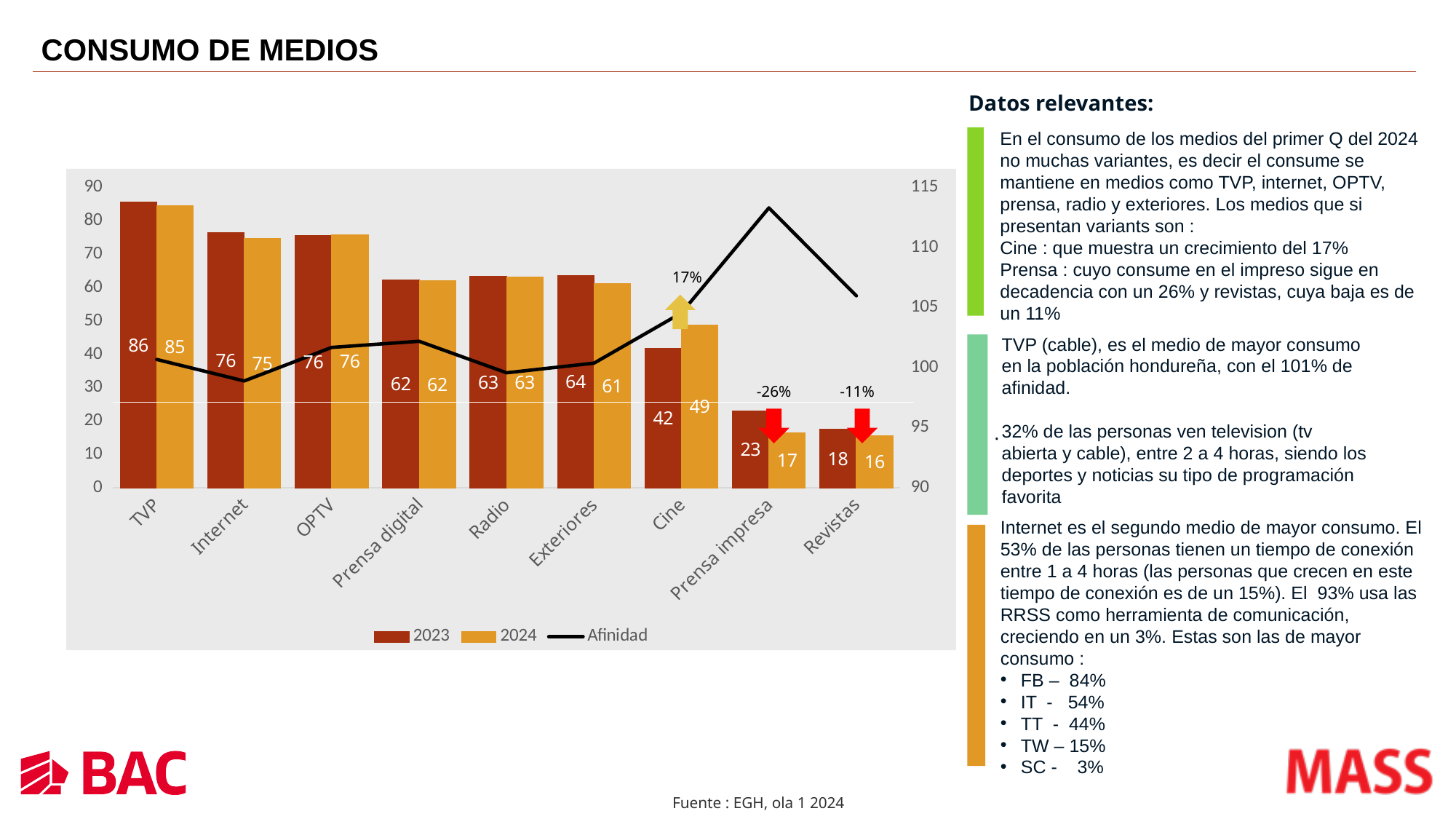
By how much did the Cine value increase from 2023 to 2024? 7 How many series does the legend list? 3 What is the 2024 value for Cine? 49 What percentage change is labelled above the Prensa impresa bars? -26% What kind of chart is used to show the 2023 and 2024 values? bar chart Which category has the highest 2024 value? TVP Is the Afinidad value for Cine greater or less than 110? less What is the 2023 value for Prensa impresa? 23 Which category has the lowest 2024 value? Revistas How many media categories are shown on the x axis? 9 For Exteriores, which year has the larger value, 2023 or 2024? 2023 What is the 2023 value for TVP? 86